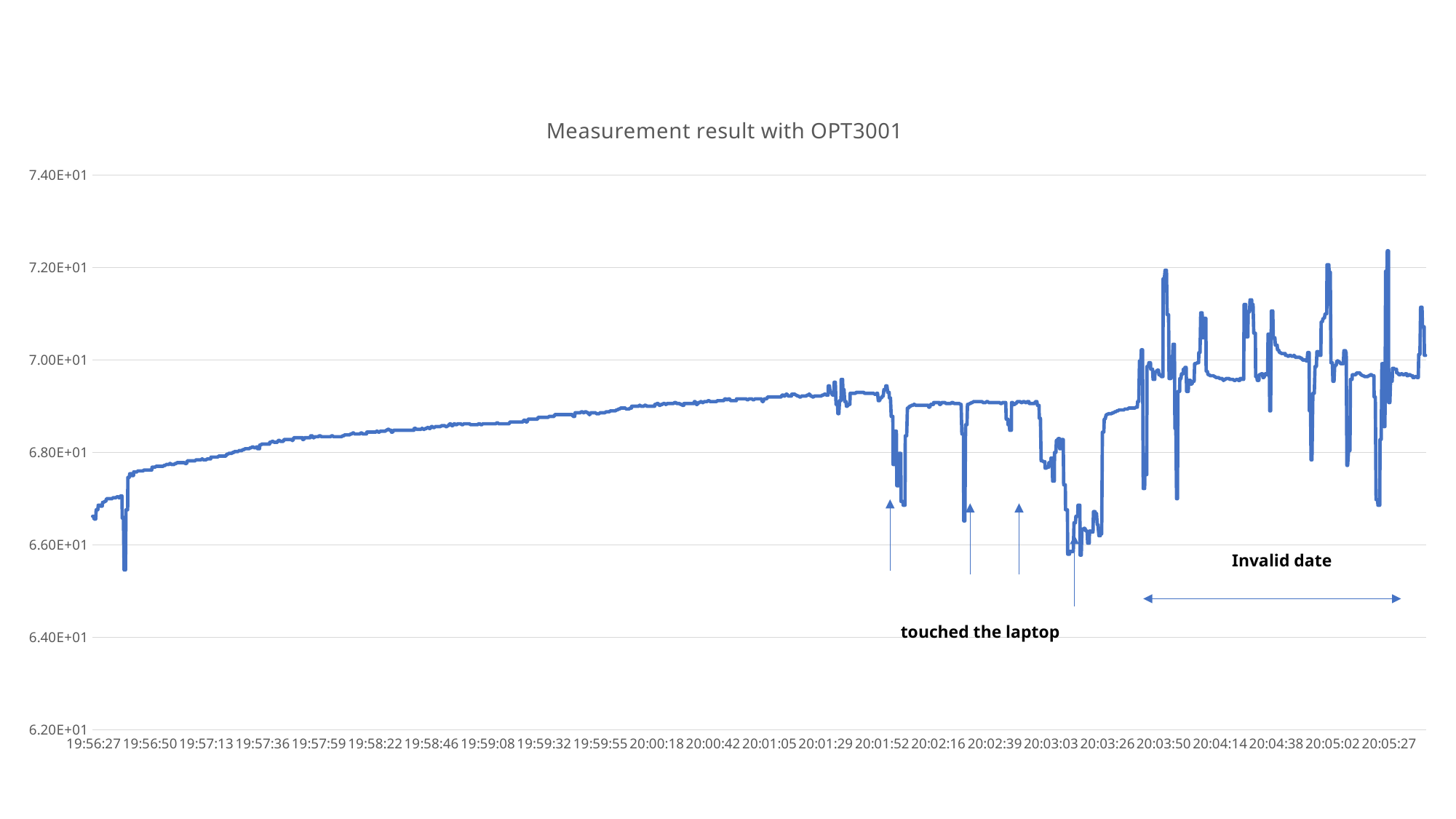
Which is larger, the value at 19:56:50 or the value at 20:00:18? 20:00:18 How many time labels are shown on the x axis? 24 Does the plotted value rise or fall along the x axis between 19:56:27 and 20:01:29? rise Is the value at 19:59:08 greater or less than 6.80E+01? greater What kind of chart is shown on the slide? line chart What is the lowest tick value shown on the y axis? 6.20E+01 How many lines are plotted on the chart? 1 What is the title of the chart? Measurement result with OPT3001 What is the highest tick value shown on the y axis? 7.40E+01 Is the value at 19:56:27 greater or less than 6.80E+01? less Is the value at 20:04:14 greater or less than 6.80E+01? greater